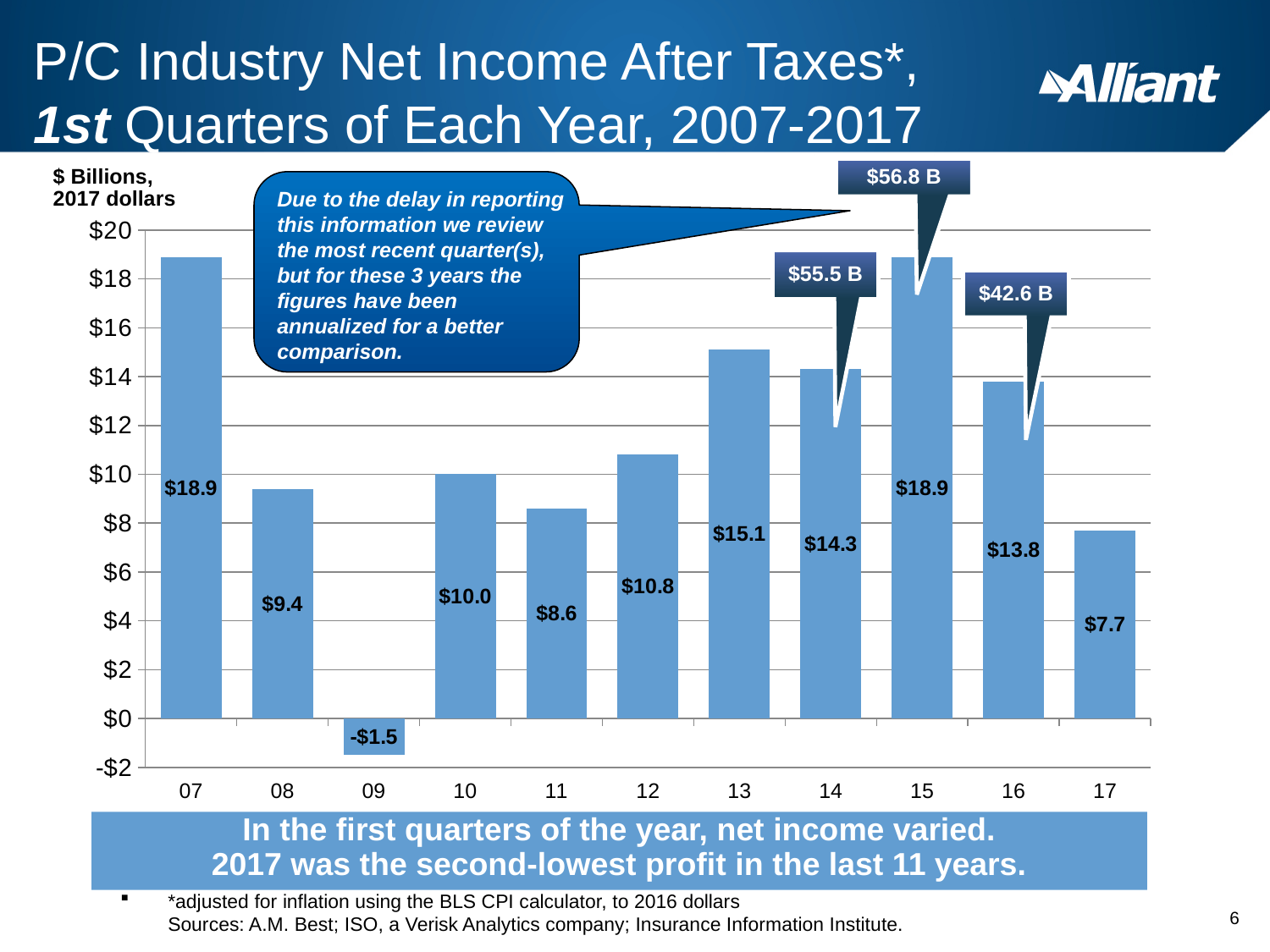
What is the difference between the 2013 value and the 2014 value? $0.8 What kind of chart is shown on the slide? Bar chart How many years are shown on the x axis? 11 What annualized figure is shown in the callout for 2015? $56.8 B What is the P/C industry net income after taxes for the 1st quarter of 2013? $15.1 Which is larger, the value for 2010 or the value for 2011? 2010 What value is shown for the 1st quarter of 2009? -$1.5 What is the value shown for 2017? $7.7 What is the difference between the 2015 value and the 2016 value? $5.1 Do the values rise or fall from 2015 to 2017? Fall Which year has the lowest 1st-quarter net income? 09 Is the value for 2012 greater or less than $10? greater